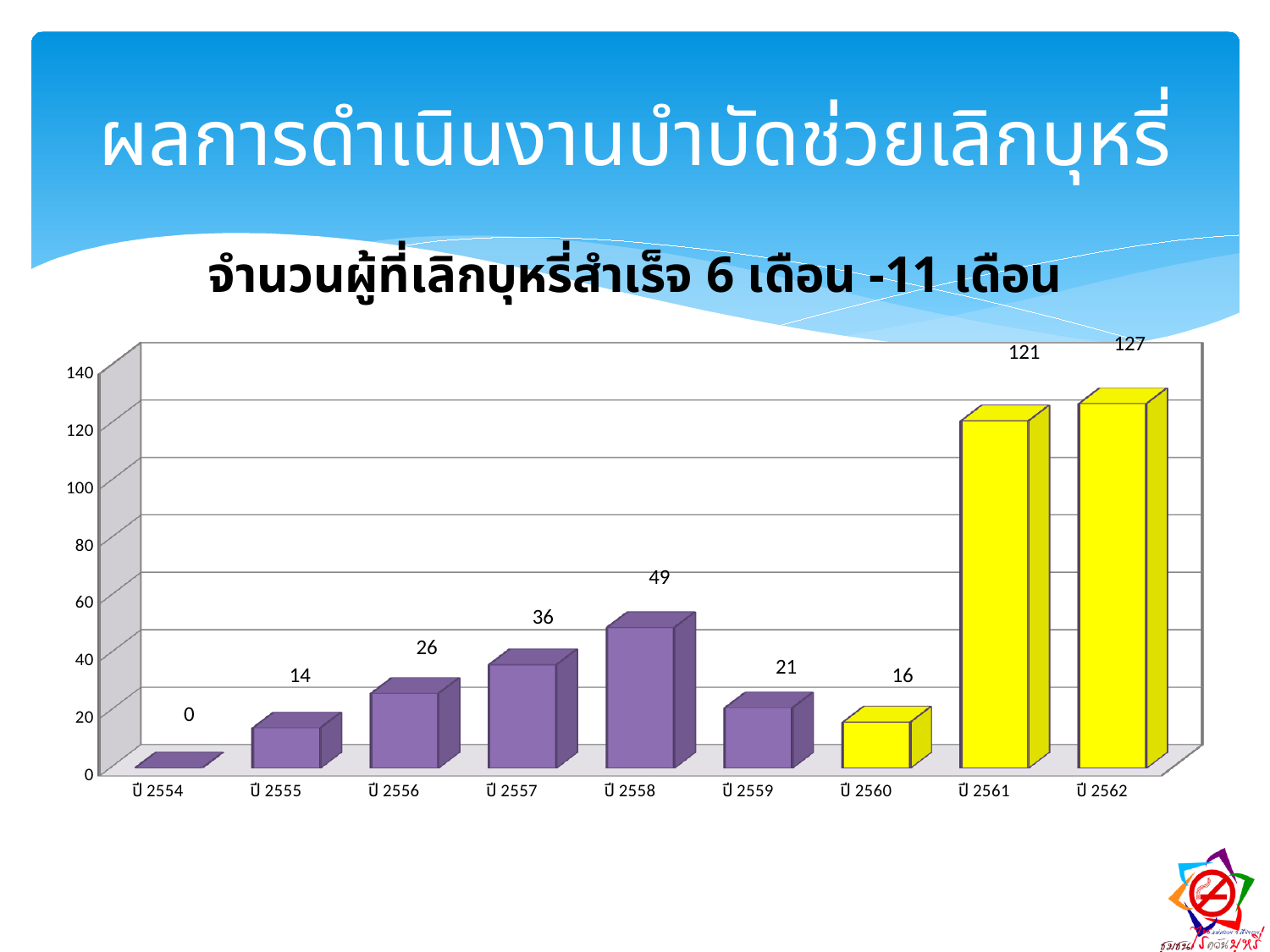
What is the value for ปี 2561? 121 What is the value for ปี 2555? 14 Which is larger, the value for ปี 2557 or the value for ปี 2560? ปี 2557 What kind of chart is shown on the slide? bar chart Which year has the highest value? ปี 2562 What is the value for ปี 2558? 49 What is the title of the chart? จำนวนผู้ที่เลิกบุหรี่สำเร็จ 6 เดือน -11 เดือน What is the difference between the values for ปี 2562 and ปี 2561? 6 How many years are shown on the x axis? 9 Do the values rise or fall from ปี 2554 to ปี 2558? rise Which year has the lowest value? ปี 2554 What is the difference between the values for ปี 2558 and ปี 2559? 28